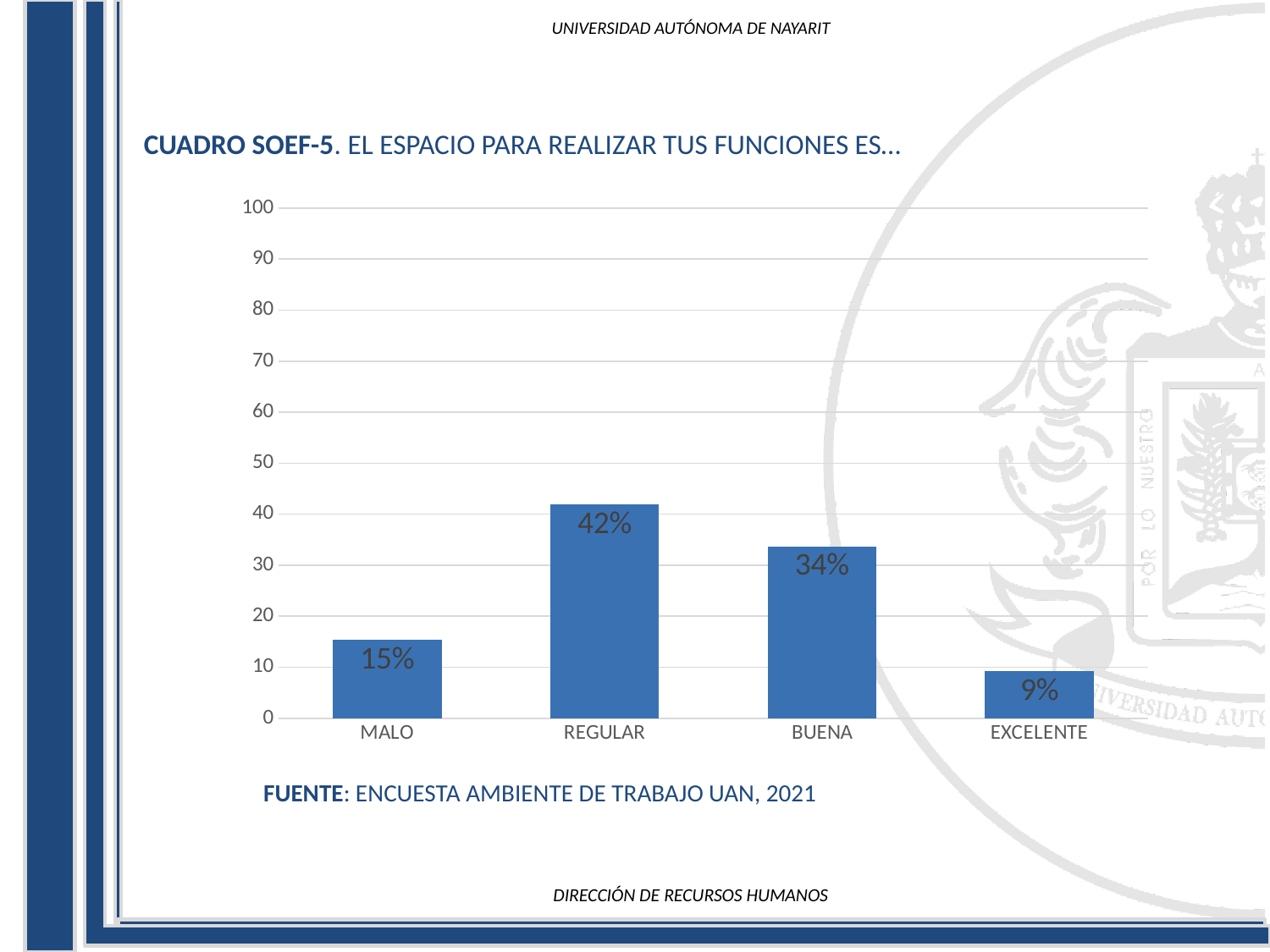
What is the value for EXCELENTE? 9% Is the value for BUENA greater or less than 30? greater What is the value for MALO? 15% What is the difference between the values for REGULAR and BUENA? 8% Which category has the lowest value? EXCELENTE Which category has the highest value? REGULAR Which is larger, the value for MALO or the value for BUENA? BUENA What kind of chart is shown on the slide? bar chart What is the highest value shown on the y axis? 100 How many categories are shown on the x axis? 4 What is the source cited below the chart? ENCUESTA AMBIENTE DE TRABAJO UAN, 2021 What is the value for REGULAR? 42%